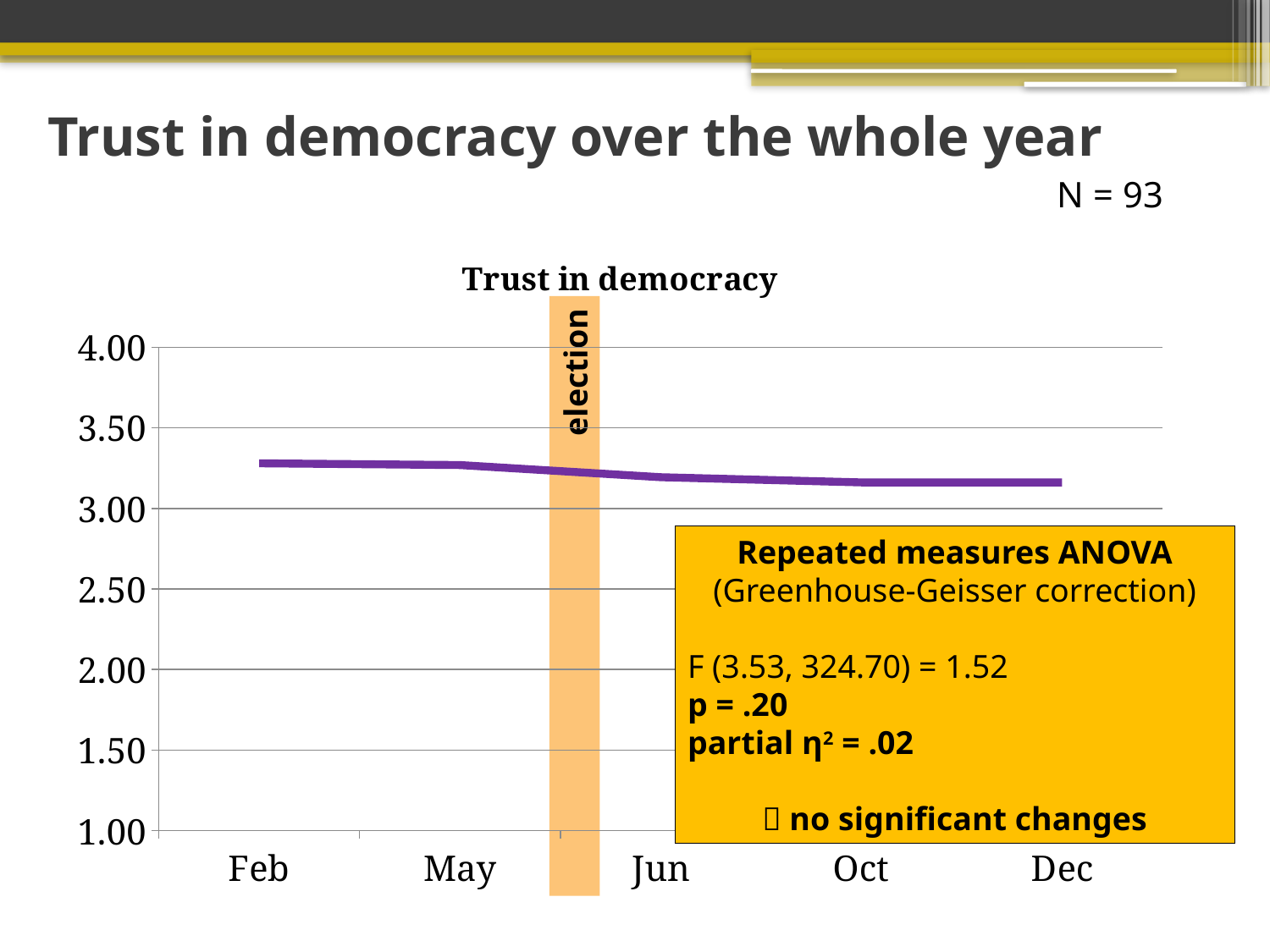
Which has the larger value, Feb or Dec? Feb Do the values in the chart rise or fall from Feb to Dec? fall What kind of chart is shown on the slide? line chart What is the title of the chart? Trust in democracy What is the highest value shown on the y axis of the chart? 4.00 How many time points are plotted on the x axis of the chart? 5 Is the value for May greater or less than 3.50? less Is the value for Feb greater or less than 3.00? greater Is the value for Dec greater or less than 3.50? less Which months are shown on the x axis of the chart? Feb, May, Jun, Oct, Dec